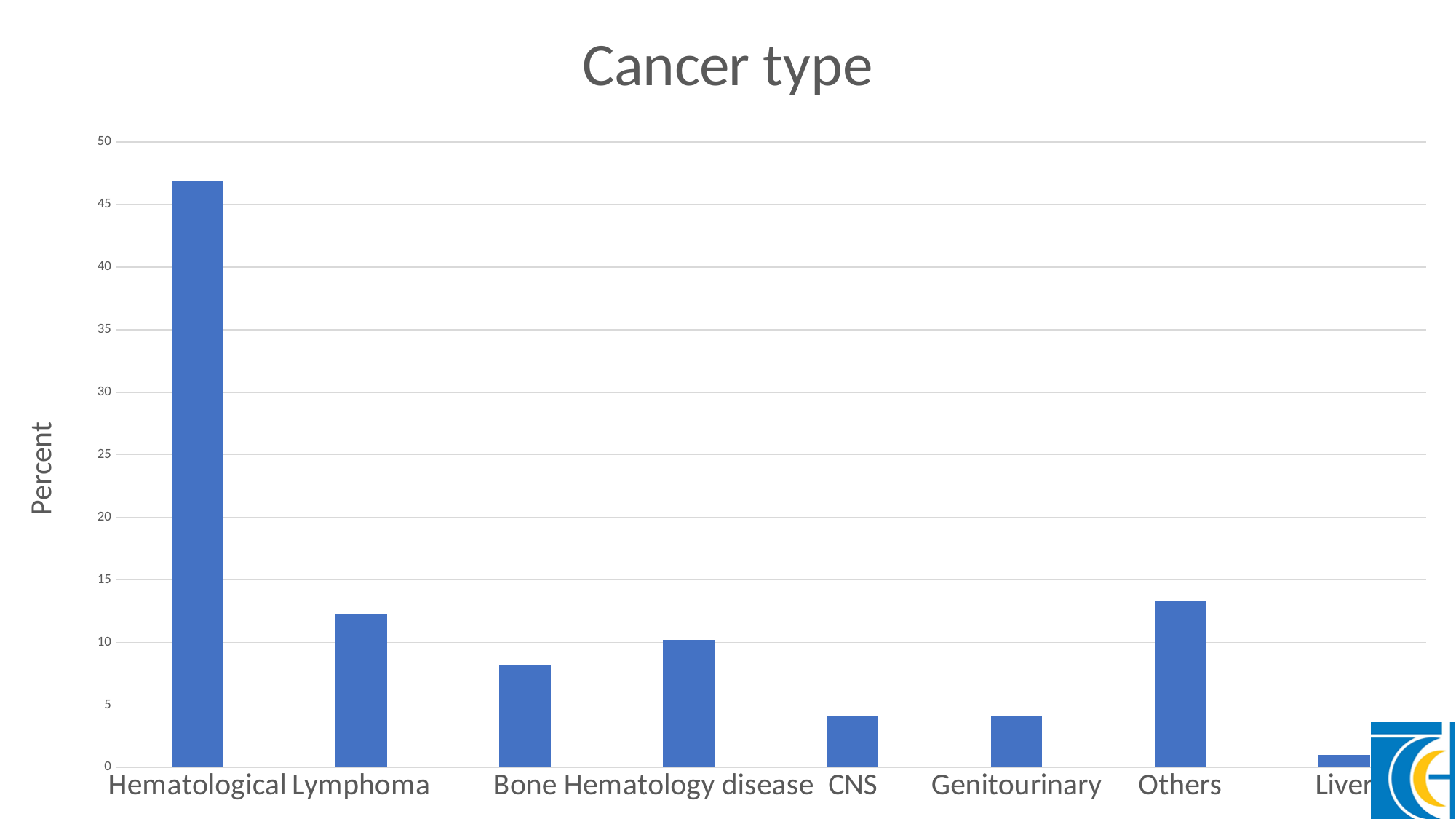
Is the value for Bone greater or less than 10? less What is the label on the vertical axis? Percent Is the value for Liver greater or less than 5? less How many cancer type categories are shown on the x axis? 8 Is the value for Lymphoma greater or less than 10? greater Which is larger, the value for Lymphoma or the value for Bone? Lymphoma What is the title of the chart? Cancer type Which category has the lowest bar? Liver What kind of chart is shown on the slide? bar chart Which category has the highest bar? Hematological